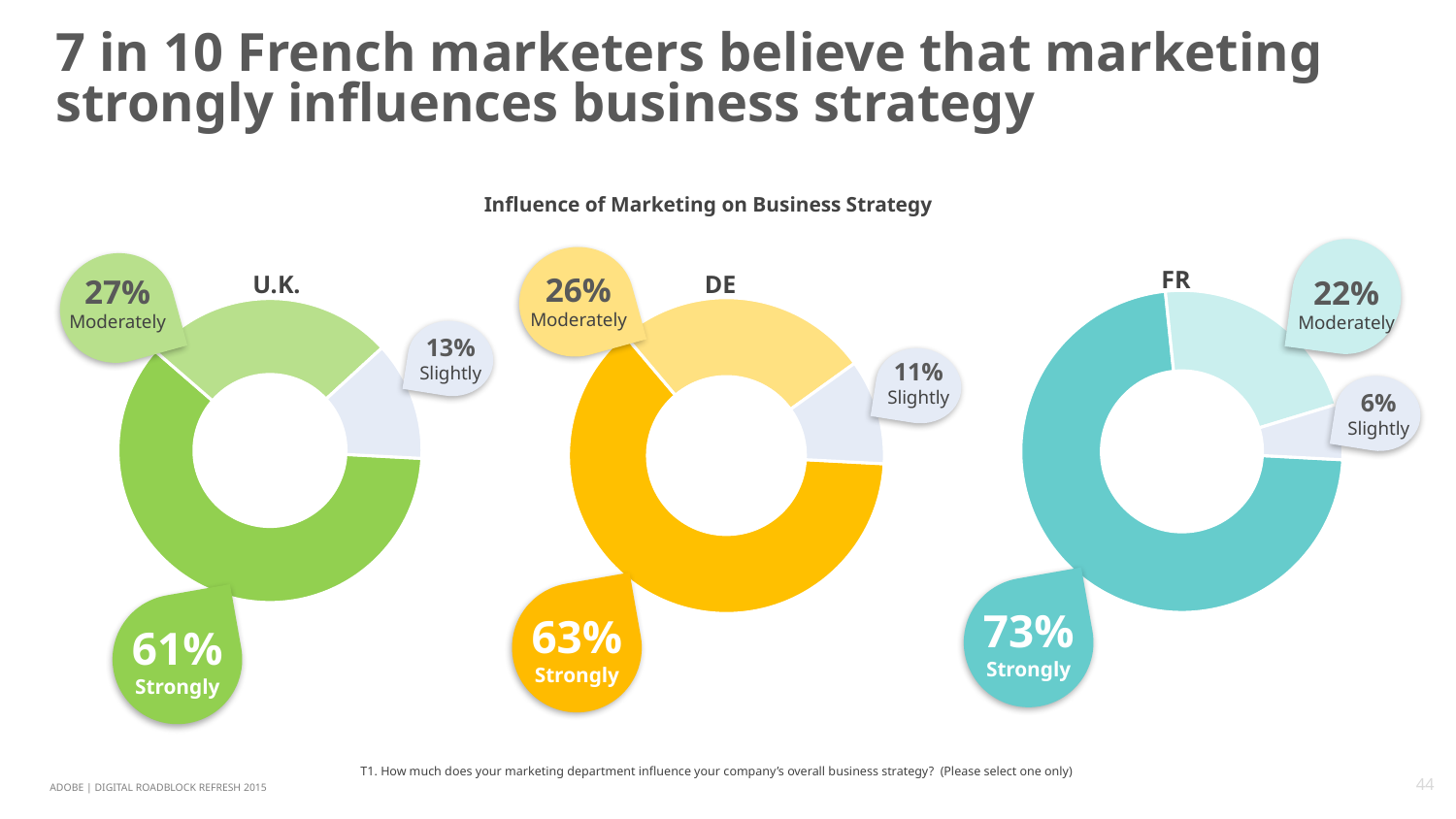
In the U.K. chart, what percentage of marketers say marketing strongly influences business strategy? 61% What is the title shown above the three charts? Influence of Marketing on Business Strategy In the DE chart, which response has the smallest share? Slightly How many response categories are shown in the DE chart? 3 What type of chart is used for the U.K., DE and FR data? Donut (pie) chart In the DE chart, what percentage of marketers say marketing moderately influences business strategy? 26% Which is larger: the 'Moderately' share in the U.K. chart or the 'Moderately' share in the FR chart? U.K. What is the difference between the 'Strongly' share in the FR chart and the 'Strongly' share in the U.K. chart? 12 percentage points How many charts are shown on the slide? 3 In the U.K. chart, what is the difference between the 'Moderately' and 'Slightly' shares? 14 percentage points In the FR chart, which response has the largest share? Strongly In the FR chart, what percentage of marketers say marketing slightly influences business strategy? 6%